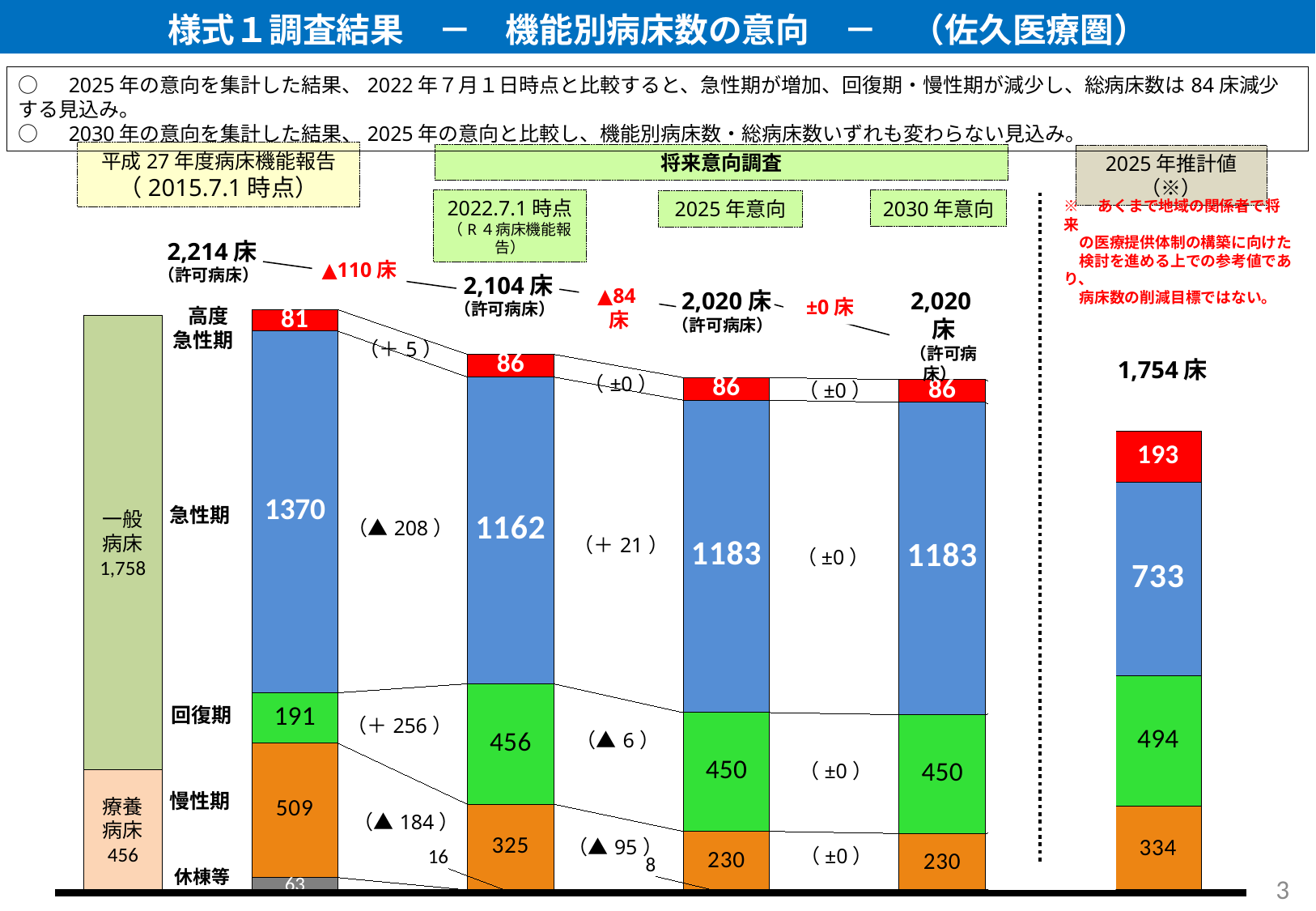
2022.7.1時点の慢性期と2025年意向の慢性期では、どちらの病床数が多いですか？ 2022.7.1時点 平成27年度病床機能報告（2015.7.1時点）の慢性期の病床数はいくつですか？ 509 2030年意向の総病床数（許可病床）はいくつですか？ 2,020床 2015.7.1時点から2030年意向にかけて、総病床数（許可病床）は増加していますか、減少していますか？ 減少 2025年推計値の棒の中で、最も病床数が少ない機能はどれですか？ 高度急性期 2022.7.1時点の急性期の病床数はいくつですか？ 1162 2015.7.1時点と2022.7.1時点の回復期の病床数の差はいくつですか？ 265 2015.7.1時点の棒の中で、最も病床数が多い機能はどれですか？ 急性期 このスライドのグラフはどの種類のグラフですか？ 積み上げ棒グラフ 2025年意向の回復期の病床数はいくつですか？ 450 2025年推計値の高度急性期の病床数はいくつですか？ 193 グラフで急性期を表す色は何色ですか？ 青